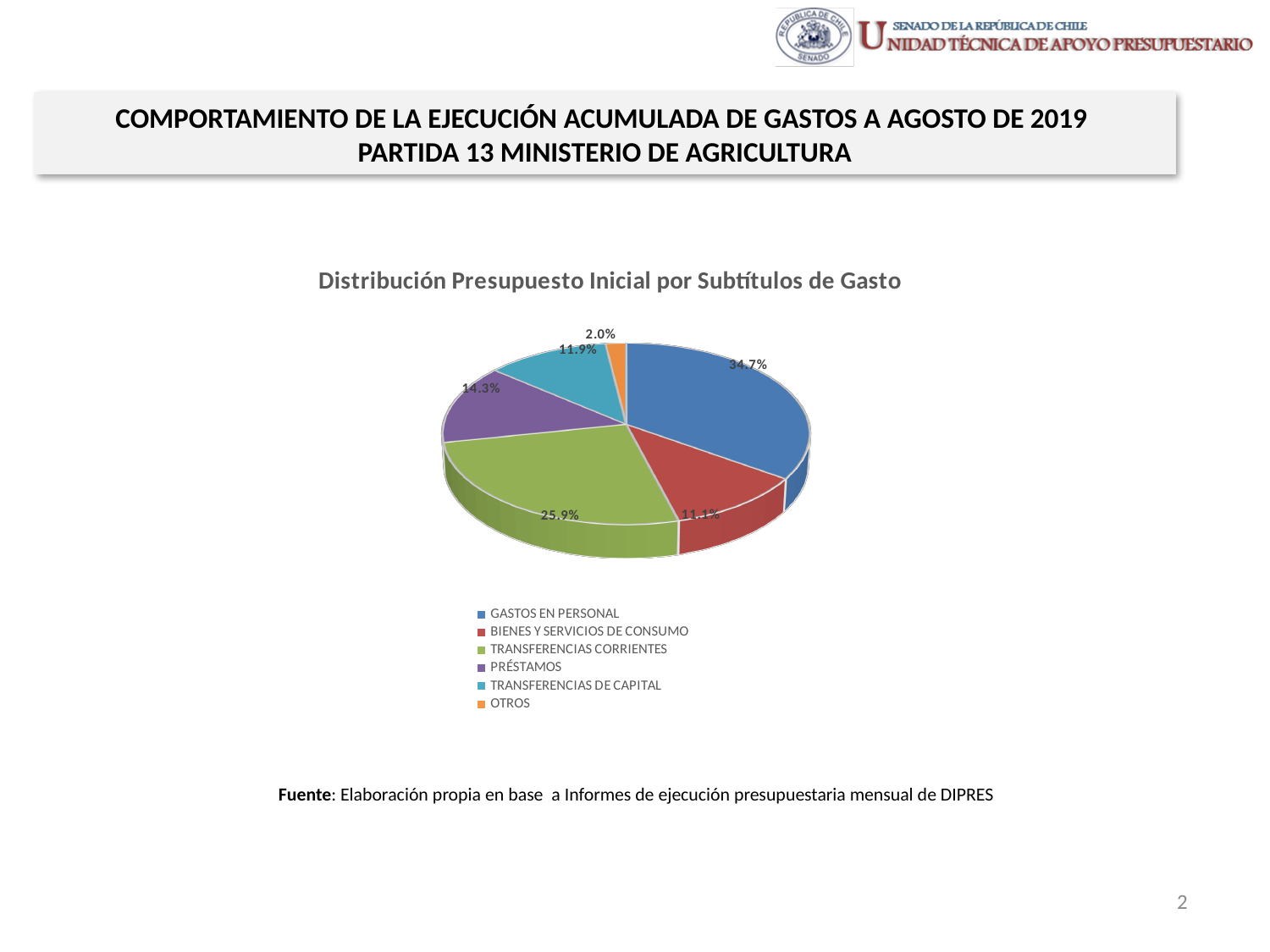
Which is larger, the share for PRÉSTAMOS or the share for TRANSFERENCIAS DE CAPITAL? PRÉSTAMOS How many categories does the legend list? 6 What is the title of the chart? Distribución Presupuesto Inicial por Subtítulos de Gasto What is the value shown for OTROS? 2.0% What is the value shown for PRÉSTAMOS? 14.3% What share of the pie does GASTOS EN PERSONAL represent? 34.7% What kind of chart is shown on the slide? Pie chart What is the difference between the shares of GASTOS EN PERSONAL and TRANSFERENCIAS CORRIENTES? 8.8% What is the value shown for BIENES Y SERVICIOS DE CONSUMO? 11.1% Which category has the smallest slice of the pie? OTROS Which category has the largest slice of the pie? GASTOS EN PERSONAL What is the value shown for TRANSFERENCIAS CORRIENTES? 25.9%